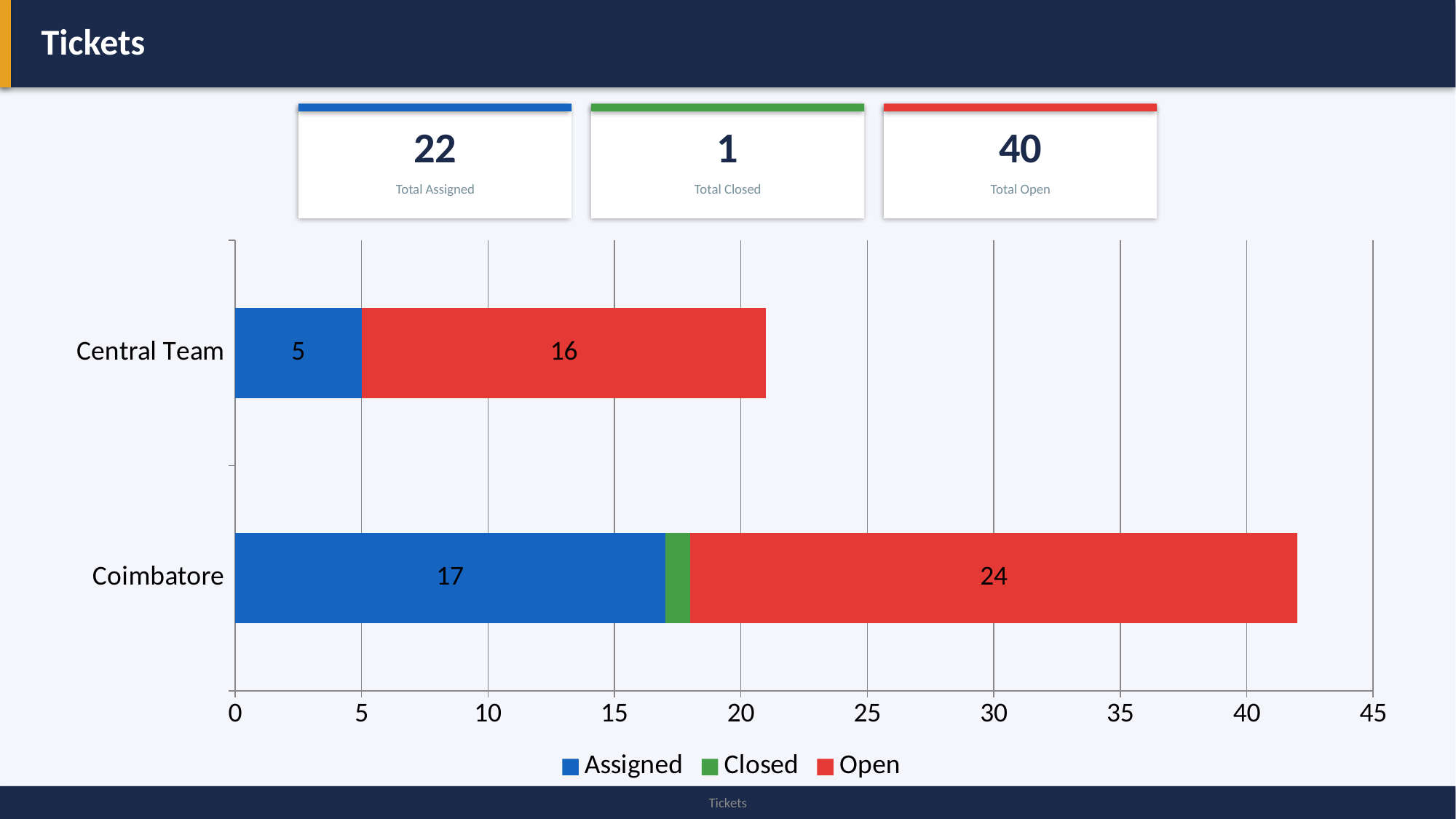
What is the Open value for Central Team? 16 What is the difference between the Open values for Coimbatore and Central Team? 8 How many series does the legend list? 3 What kind of chart is shown on the slide? Stacked bar chart What is the Assigned value for Central Team? 5 How many categories are shown on the chart? 2 Is the total length of the Coimbatore stacked bar greater or less than 40? greater Which category has the higher Open value? Coimbatore What is the Assigned value for Coimbatore? 17 What is the difference between the Assigned values for Coimbatore and Central Team? 12 For Central Team, which is larger: the Assigned value or the Open value? Open What is the Open value for Coimbatore? 24